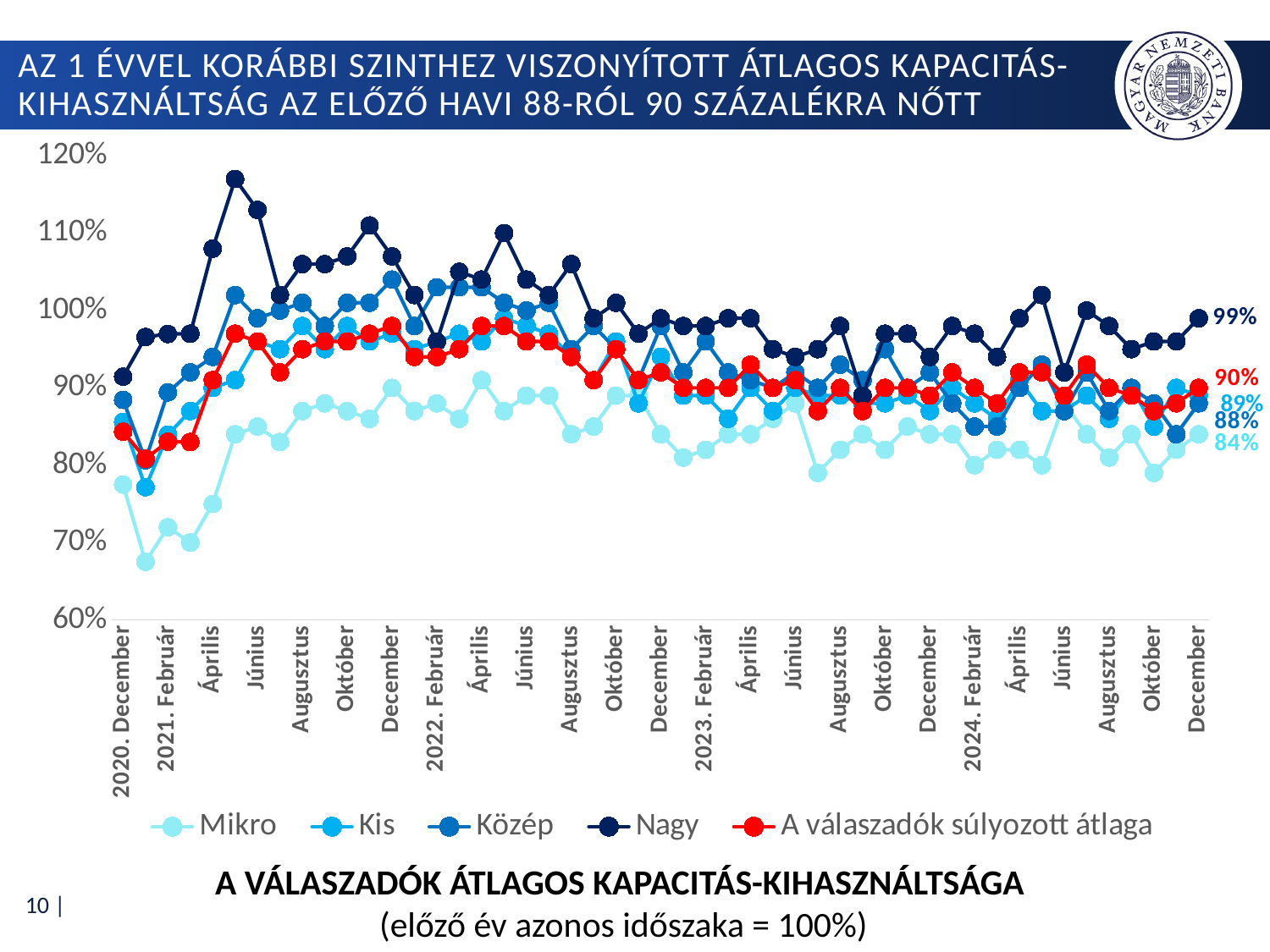
Which series is drawn in red? A válaszadók súlyozott átlaga What is the value for the Közép series at 2024 December? 88% Which series has the lowest value at 2024 December? Mikro What is the value for the Mikro series at 2024 December? 84% Which series has the highest value at 2024 December? Nagy What is the value for the Kis series at 2024 December? 89% What is the value for the Nagy series at 2024 December? 99% What is the value for 'A válaszadók súlyozott átlaga' at 2024 December? 90% What kind of chart is shown on the slide? line chart Is the value for Mikro at 2021. Február greater or less than 80%? less What is the difference between the Nagy and Mikro values at 2024 December? 15 percentage points How many series does the legend list? 5